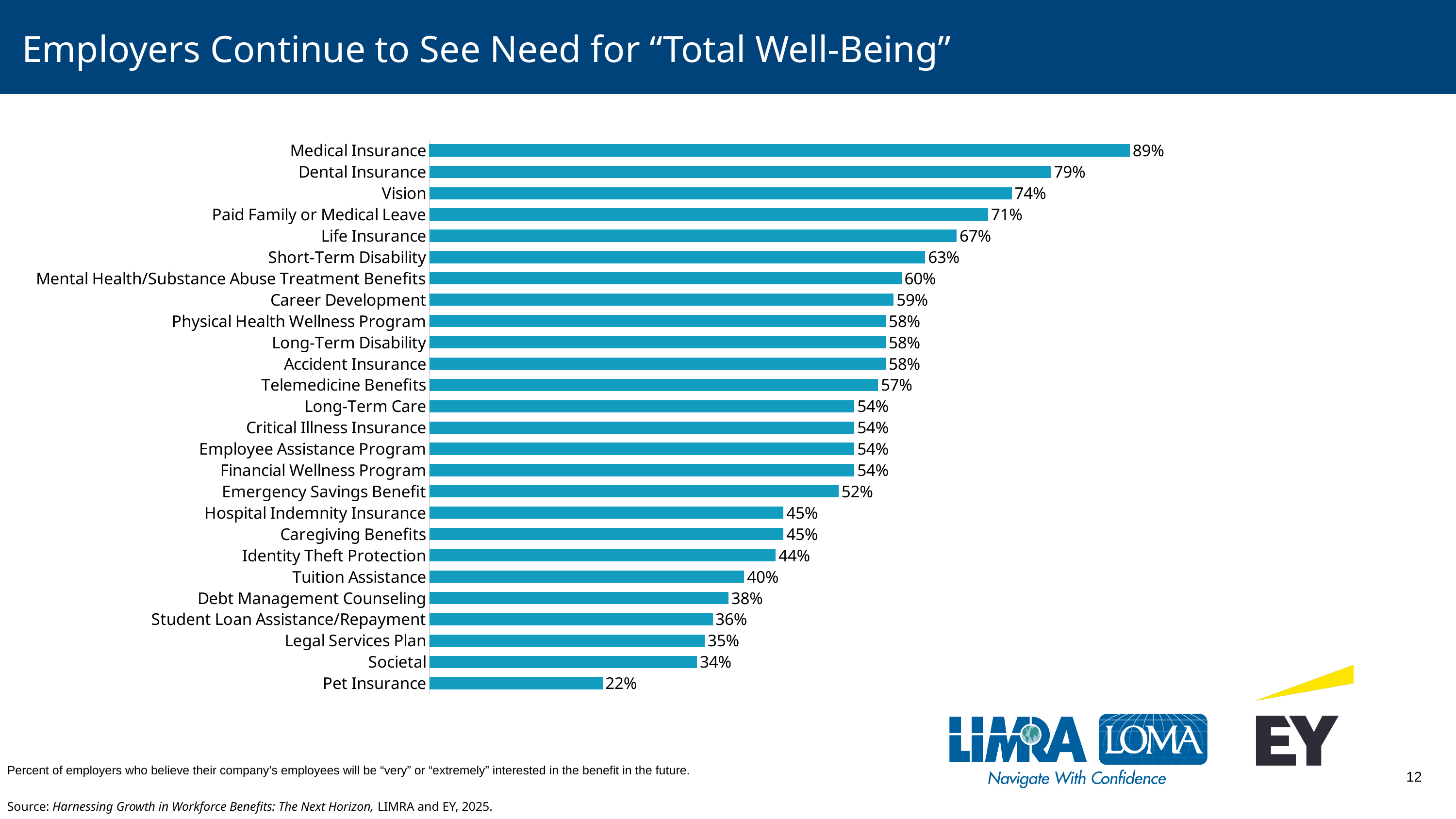
What percentage is shown for Emergency Savings Benefit? 52% What percentage is shown for Medical Insurance? 89% What is the value for Student Loan Assistance/Repayment? 36% Which benefit has the highest percentage? Medical Insurance How many benefit categories are shown in the chart? 26 What is the value for Paid Family or Medical Leave? 71% What is the title of the slide? Employers Continue to See Need for "Total Well-Being" What kind of chart is shown on the slide? Bar chart Which benefit has the lowest percentage? Pet Insurance What is the difference between the values for Medical Insurance and Pet Insurance? 67% What is the difference between the values for Dental Insurance and Vision? 5% Which is larger, the value for Tuition Assistance or the value for Legal Services Plan? Tuition Assistance